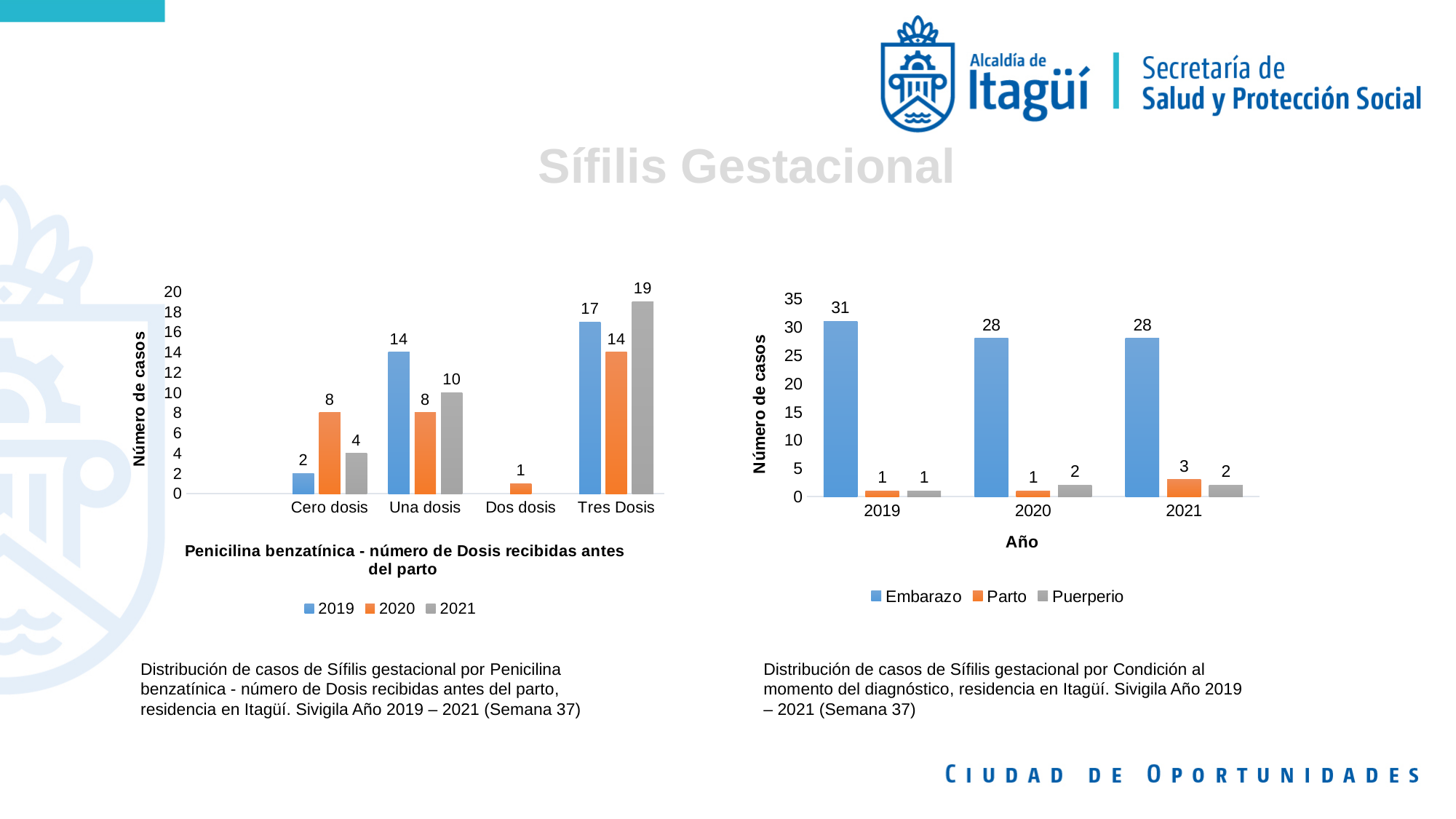
In the left chart (Penicilina benzatínica - número de Dosis recibidas antes del parto), what is the value for 2021 in the Tres Dosis category? 19 In the left chart (Penicilina benzatínica - número de Dosis recibidas antes del parto), which category has the highest value for 2019? Tres Dosis In the right chart (Condición al momento del diagnóstico), what is the Parto value for 2021? 3 In the left chart (Penicilina benzatínica - número de Dosis recibidas antes del parto), what is the difference between the 2021 and 2020 values in the Tres Dosis category? 5 What kind of chart is the right chart (Condición al momento del diagnóstico)? Bar chart In the right chart (Condición al momento del diagnóstico), which series does the legend list first? Embarazo In the right chart (Condición al momento del diagnóstico), what is the difference between the Embarazo values for 2019 and 2020? 3 In the left chart (Penicilina benzatínica - número de Dosis recibidas antes del parto), how many series does the legend list? 3 In the left chart (Penicilina benzatínica - número de Dosis recibidas antes del parto), how many categories are shown on the x axis? 4 In the left chart (Penicilina benzatínica - número de Dosis recibidas antes del parto), which is larger in the Cero dosis category: the 2020 value or the 2021 value? 2020 In the left chart (Penicilina benzatínica - número de Dosis recibidas antes del parto), what is the value for 2019 in the Una dosis category? 14 In the right chart (Condición al momento del diagnóstico), what is the Embarazo value for 2019? 31